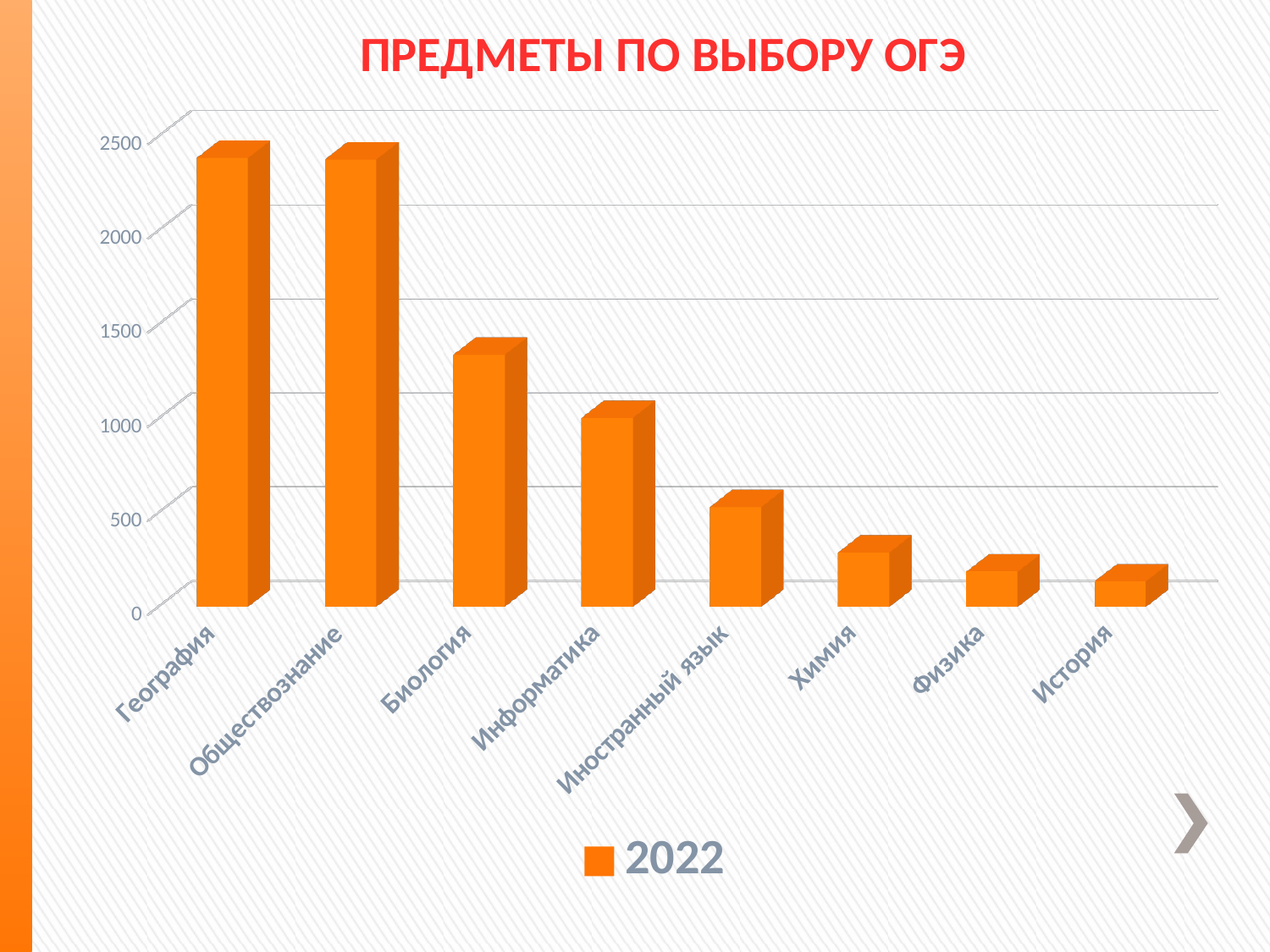
What kind of chart is shown on the slide? bar chart Is the value for Иностранный язык greater or less than 1000? less Is the value for Химия greater or less than 500? less How many subjects (categories) are shown on the x axis of the chart? 8 Which subject has the lowest bar in the chart? История What series name is shown in the chart legend? 2022 Which has the larger value, Биология or Информатика? Биология What is the title of the chart? ПРЕДМЕТЫ ПО ВЫБОРУ ОГЭ Is the value for Биология greater or less than 1500? less Do the values rise or fall moving from left to right along the x axis? fall How many series does the chart legend list? 1